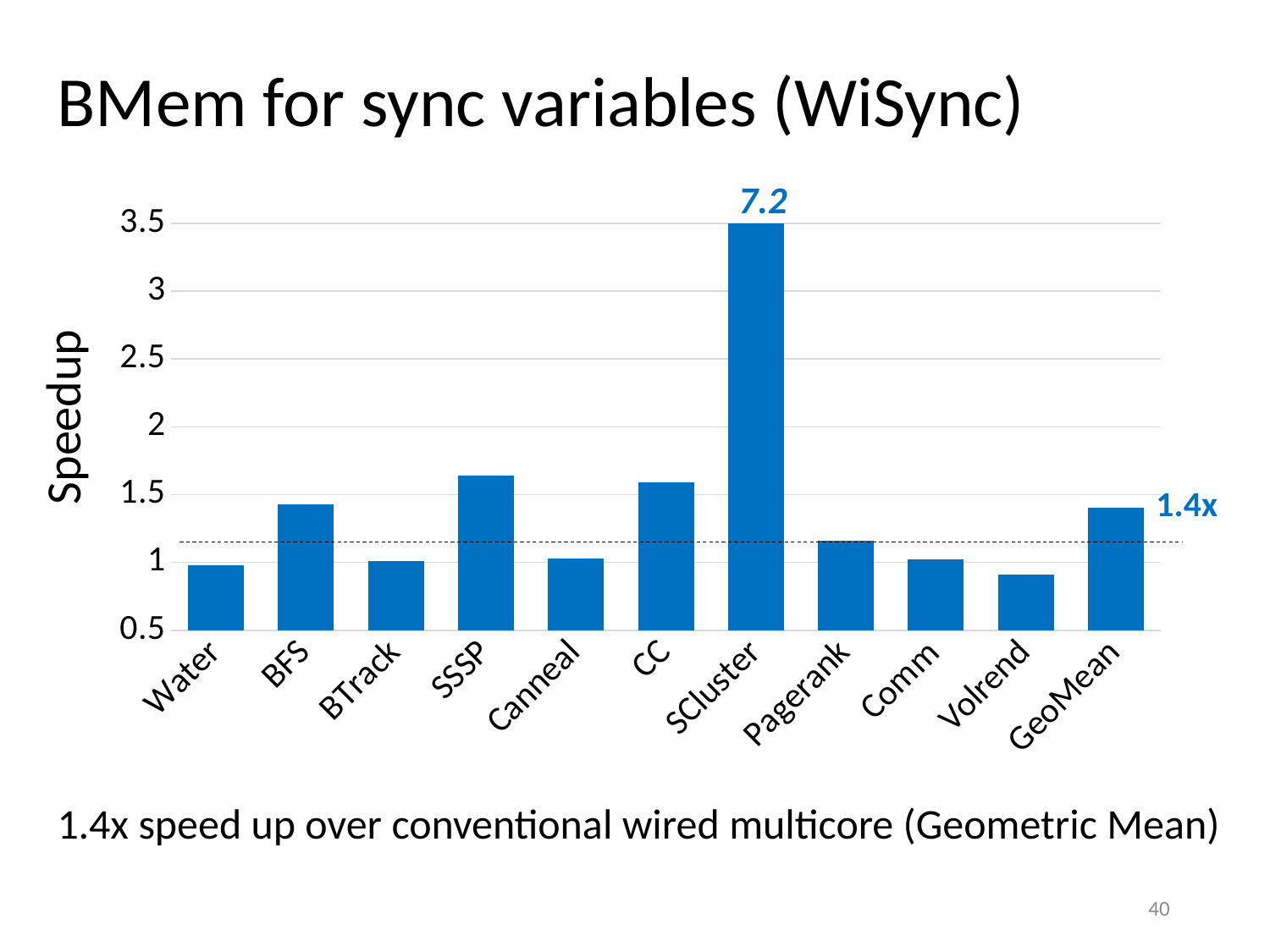
How many categories are shown on the x axis of the chart? 11 Which category has the lowest speedup in the chart? Volrend What type of chart is shown on the slide? bar chart Which category has the highest speedup in the chart? SCluster What value is labelled next to the GeoMean bar? 1.4x Is the speedup for BFS greater or less than 1.5? less Is the speedup for Volrend greater or less than 1? less Which has the larger speedup, SCluster or CC? SCluster Which has the larger speedup, SSSP or BFS? SSSP What speedup value is labelled on the SCluster bar? 7.2 What is the label on the vertical axis of the chart? Speedup Is the speedup for SSSP greater or less than 1.5? greater